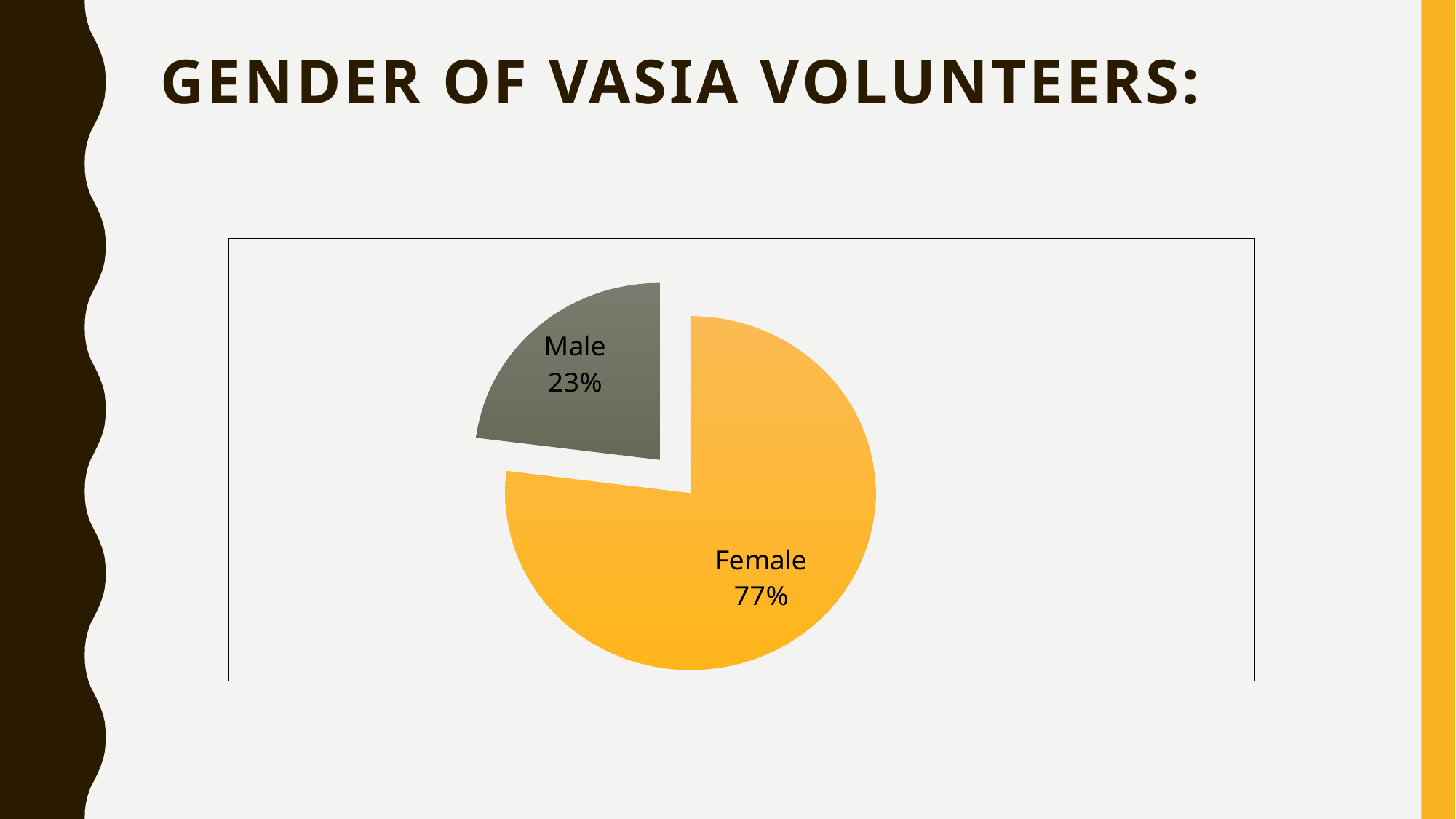
Which gender has the largest share of VASIA volunteers? Female What share of the pie does the Male slice represent? 23% What colour is the Female slice of the pie chart? yellow/orange Which is larger, the Male share or the Female share? Female What is the title of the slide containing the chart? Gender of VASIA Volunteers: Which gender has the smallest share of VASIA volunteers? Male What percentage of VASIA volunteers are male? 23% What percentage of VASIA volunteers are female? 77% What is the difference in percentage points between the Female and Male shares? 54 What kind of chart is shown on the slide? pie chart How many slices does the pie chart have? 2